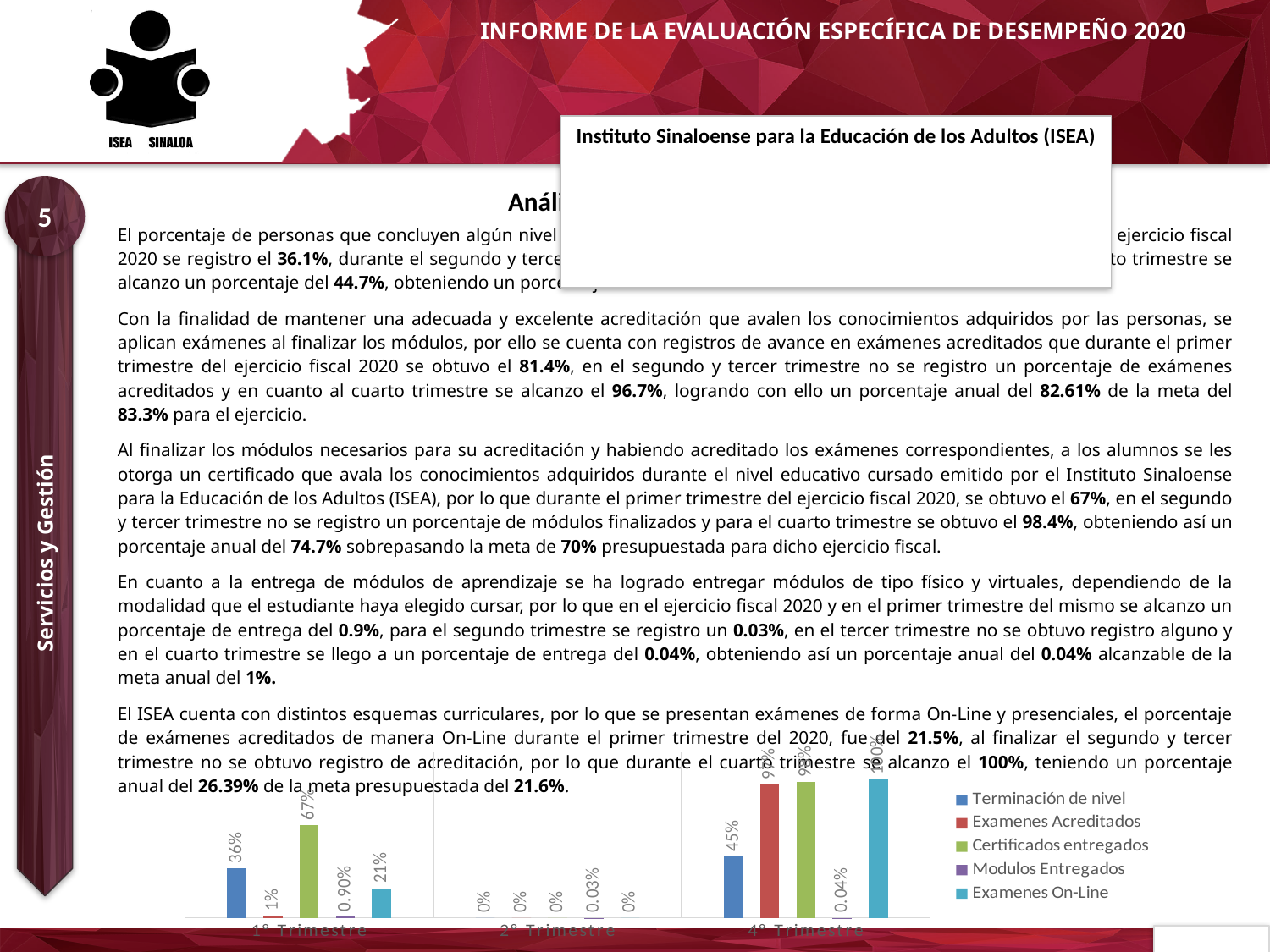
How many series does the chart legend list? 5 What is the difference between Certificados entregados and Terminación de nivel in 1° Trimestre? 31 percentage points What is the value for Certificados entregados in 1° Trimestre? 67% What kind of chart is shown at the bottom of the slide? Bar chart How many trimester groups are shown on the x axis of the chart? 3 What is the value for Modulos Entregados in 4° Trimestre? 0.04% What is the value for Terminación de nivel in 1° Trimestre? 36% What is the value for Modulos Entregados in 2° Trimestre? 0.03% What is the value for Examenes On-Line in 1° Trimestre? 21% Is the value for Terminación de nivel larger in 1° Trimestre or in 4° Trimestre? 4° Trimestre What is the value for Terminación de nivel in 4° Trimestre? 45% Which series has the highest value in 1° Trimestre? Certificados entregados